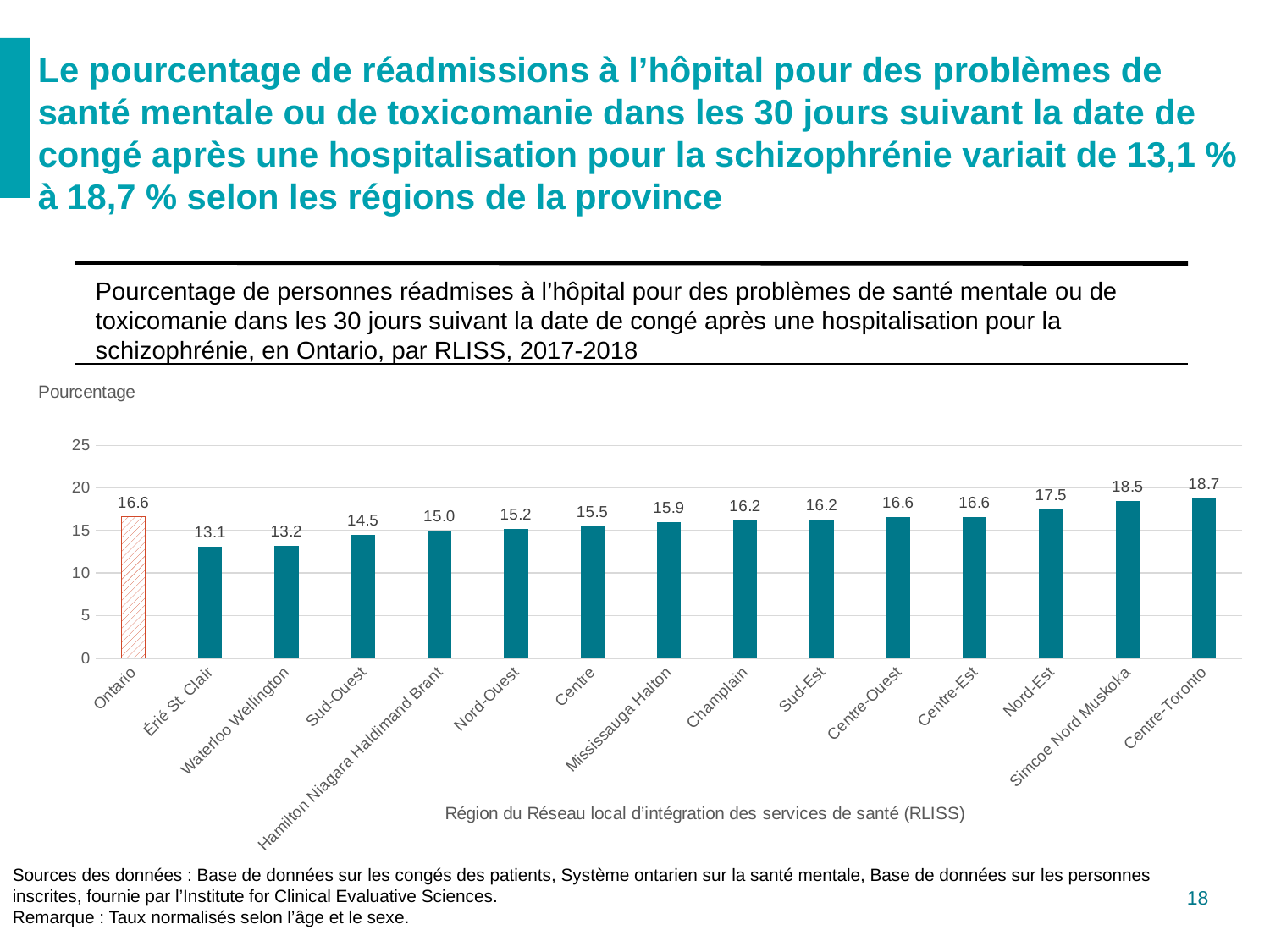
What kind of chart is shown on the slide? bar chart Which is larger, the value for Nord-Ouest or the value for Nord-Est? Nord-Est What is the difference between the values for Centre-Toronto and Érié St. Clair? 5.6 Is the value for Sud-Ouest greater or less than 15? less How many bars are shown in the chart? 15 Do the values for the RLISS regions rise or fall from left to right along the x axis? rise Which region has the highest value? Centre-Toronto What is the value for Ontario? 16.6 What is the value for Simcoe Nord Muskoka? 18.5 What is the label of the y axis? Pourcentage What is the value for Champlain? 16.2 Which region has the lowest value? Érié St. Clair